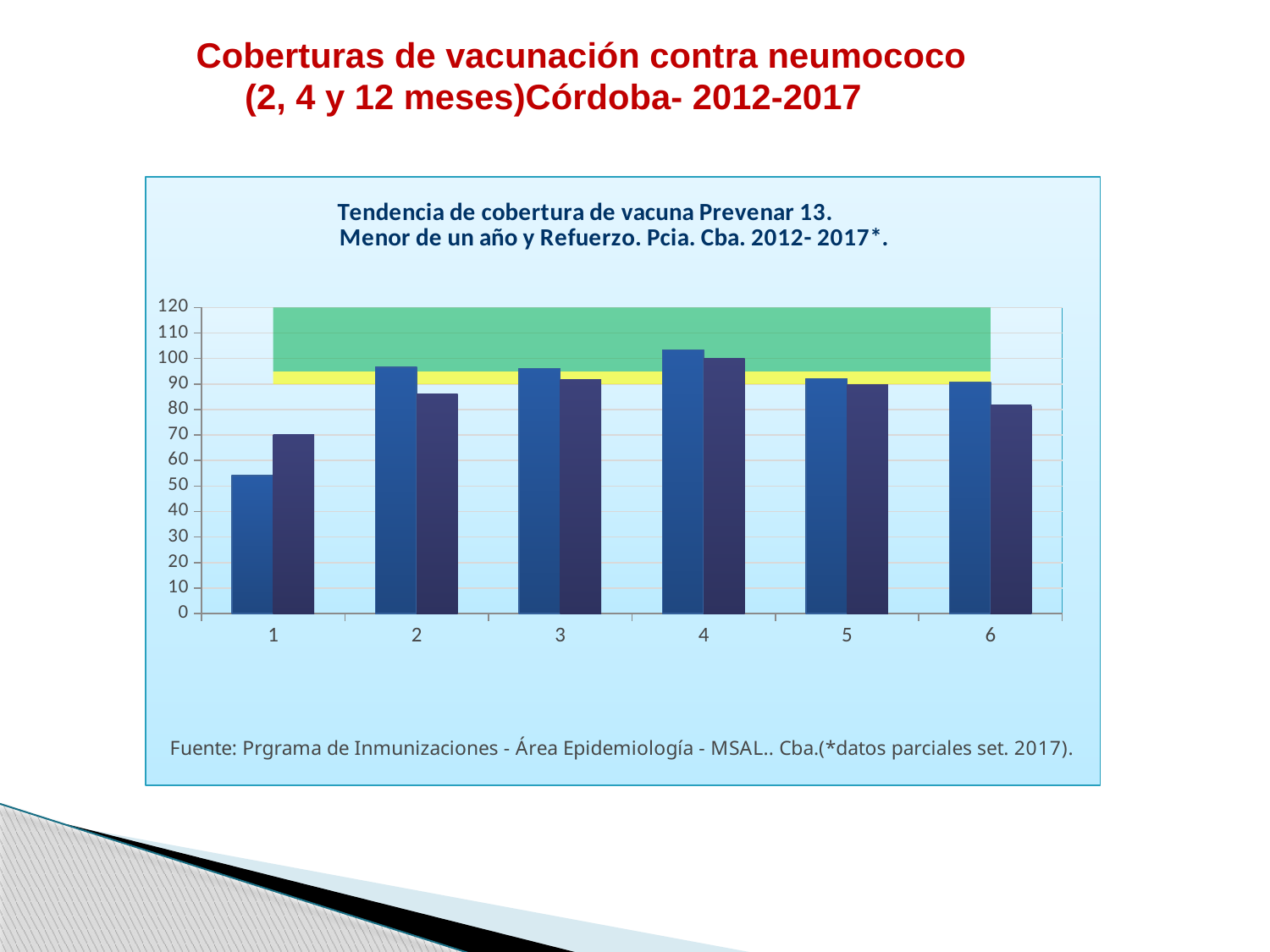
Which category has the tallest bar in the chart? 4 Is the value of the lighter blue bar for category 4 greater or less than 100? greater Is the value of the darker blue bar for category 6 greater or less than 90? less How many bars are plotted for each category on the x axis? 2 What kind of chart is shown on the slide? bar chart How many categories are shown on the x axis of the chart? 6 Do the lighter blue bars rise or fall from category 1 to category 2? rise Which category has the shortest bar in the chart? 1 For category 1, which bar is taller, the lighter blue bar or the darker blue bar? the darker blue bar Is the value of the darker blue bar for category 2 greater or less than 90? less What is the title printed inside the chart area? Tendencia de cobertura de vacuna Prevenar 13. Menor de un año y Refuerzo. Pcia. Cba. 2012- 2017*.